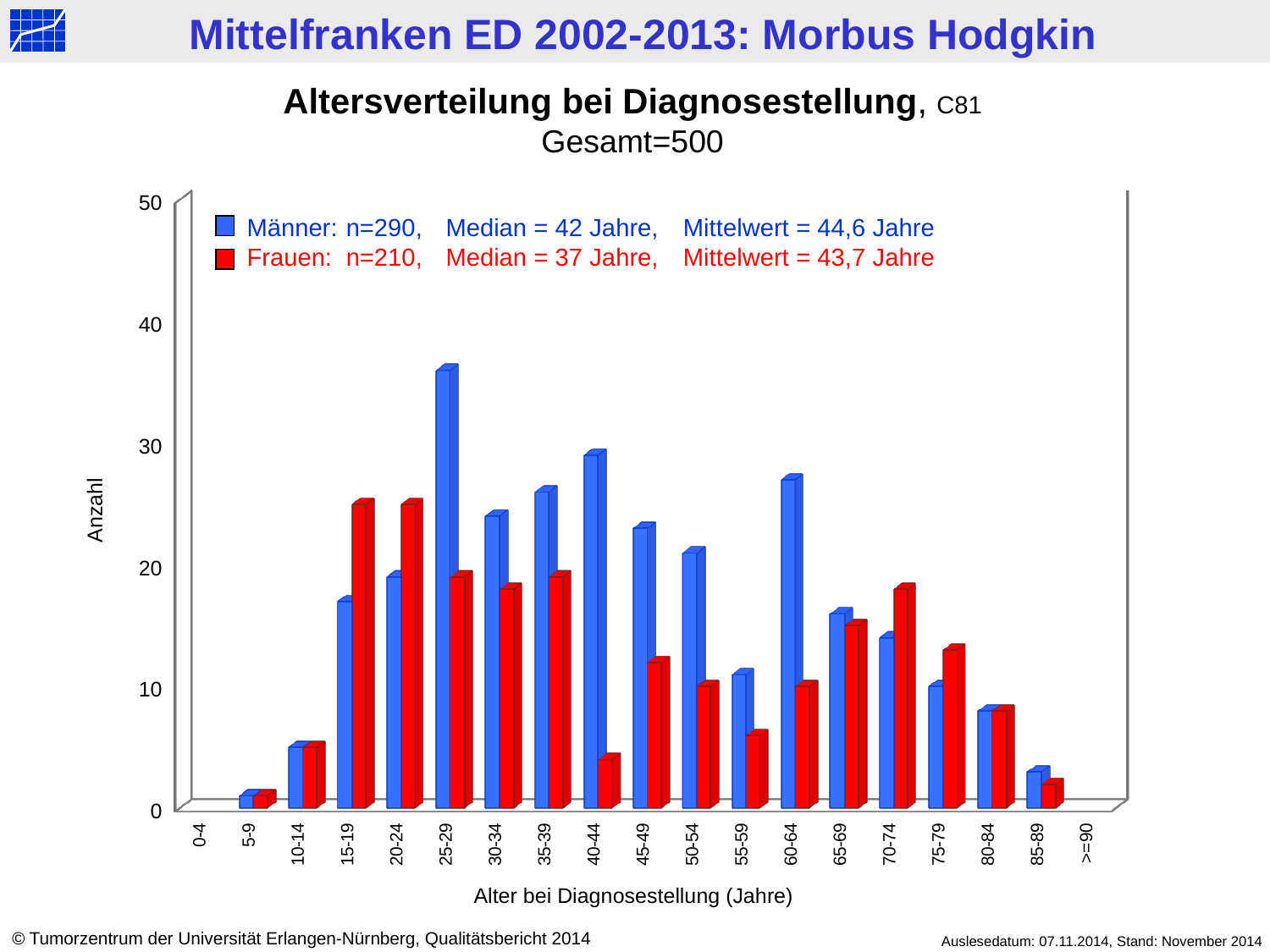
Is the value for Männer in the 60-64 age group greater or less than 30? less Is the value for Männer in the 25-29 age group greater or less than 30? greater How many age groups are shown on the x axis? 19 According to the legend, what is the median age for Frauen? 37 Jahre How many series does the legend list? 2 In the 70-74 age group, which series has the larger value, Männer or Frauen? Frauen What kind of chart is shown on the slide? bar chart In the 40-44 age group, which series has the larger value, Männer or Frauen? Männer What is the total number of cases (Gesamt) stated on the slide? 500 Which age group has the highest value for Männer? 25-29 Is the value for Frauen in the 40-44 age group greater or less than 10? less